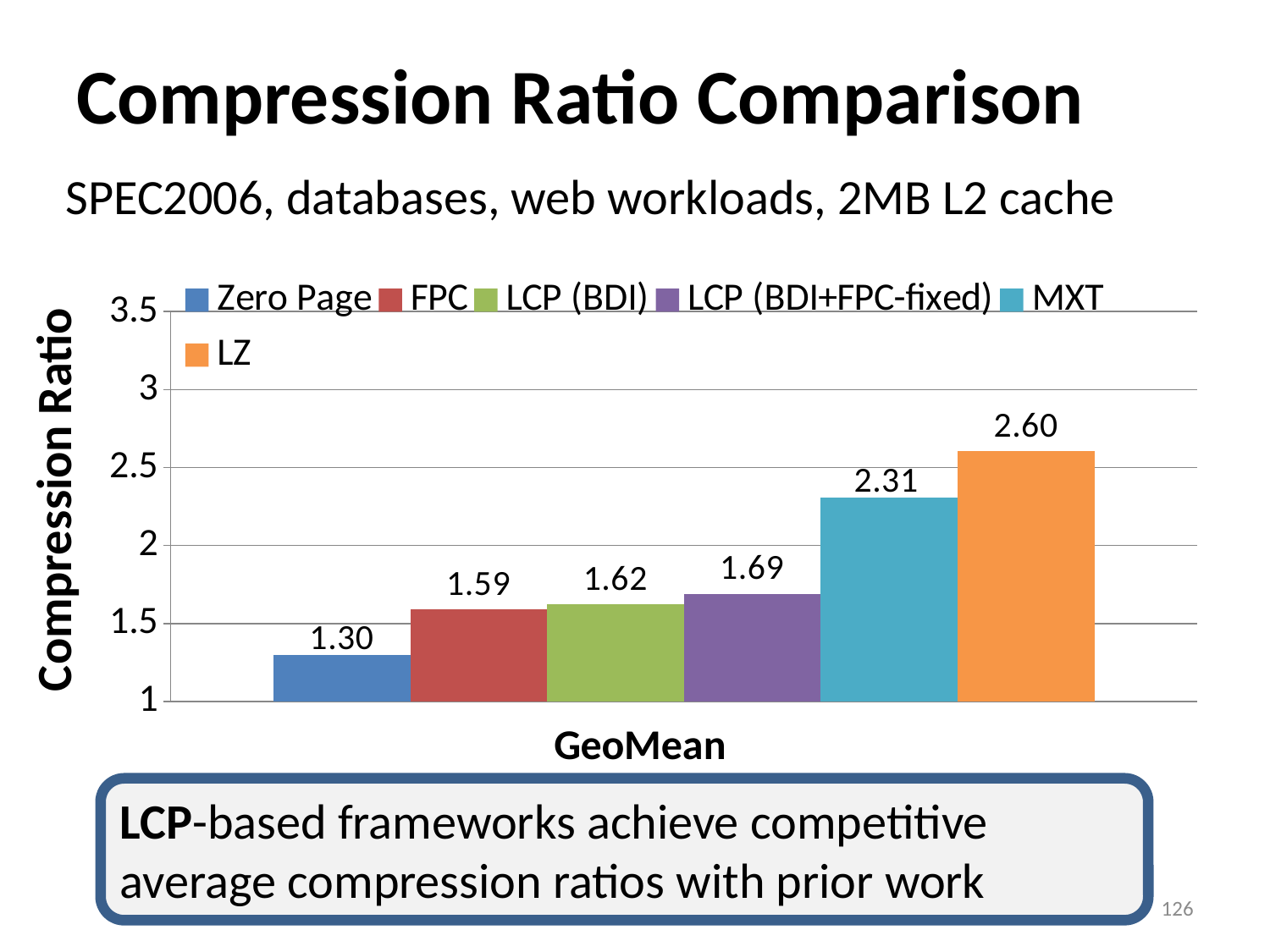
What kind of chart is shown on the slide? bar chart How many series does the legend list? 6 Which series has the lowest compression ratio? Zero Page What is the difference between the compression ratios of LZ and MXT? 0.29 What is the compression ratio for LCP (BDI+FPC-fixed)? 1.69 Which series has the highest compression ratio? LZ What is the label on the y axis of the chart? Compression Ratio What is the compression ratio for MXT? 2.31 Which has a higher compression ratio, FPC or LCP (BDI)? LCP (BDI) What is the compression ratio for Zero Page? 1.30 What is the difference between the compression ratios of LCP (BDI) and Zero Page? 0.32 Is the compression ratio for MXT greater or less than 2? greater